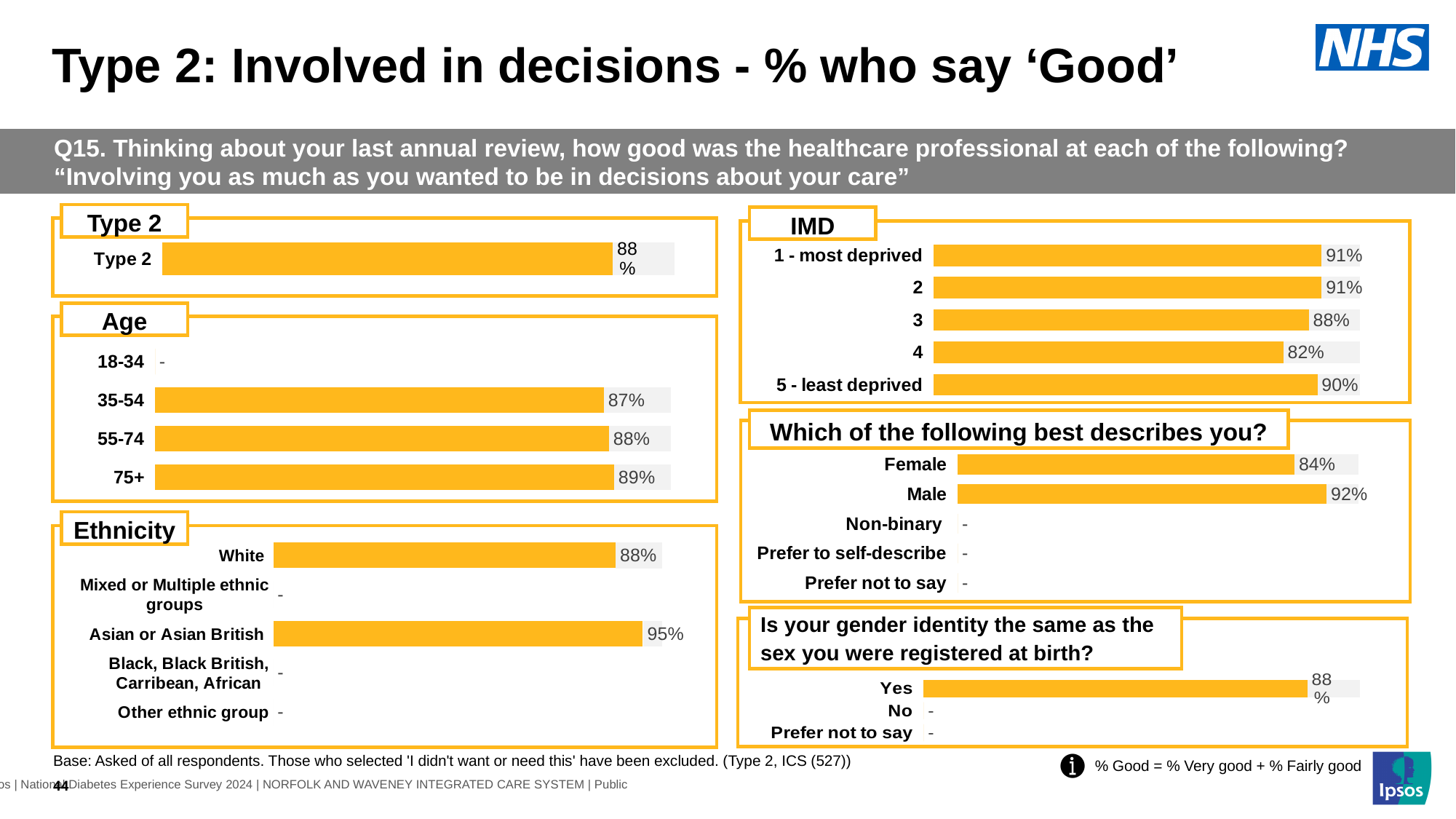
In the Ethnicity chart, what is the difference between the Asian or Asian British value and the White value? 7% In the 'Which of the following best describes you?' chart, which is larger, Female or Male? Male In the Age chart, which age group with a printed value has the lowest percentage? 35-54 In the IMD chart, what is the value for 4? 82% In the Type 2 chart, what percentage of Type 2 respondents say 'Good'? 88% In the IMD chart, how many categories are shown? 5 In the 'Which of the following best describes you?' chart, what is the difference between Male and Female? 8% In the 'Is your gender identity the same as the sex you were registered at birth?' chart, what is the value for Yes? 88% In the Ethnicity chart, what is the value for Asian or Asian British? 95% In the Age chart, what is the value for the 75+ age group? 89% In the IMD chart, which category has the lowest percentage? 4 What type of chart is used in the Age section? Bar chart